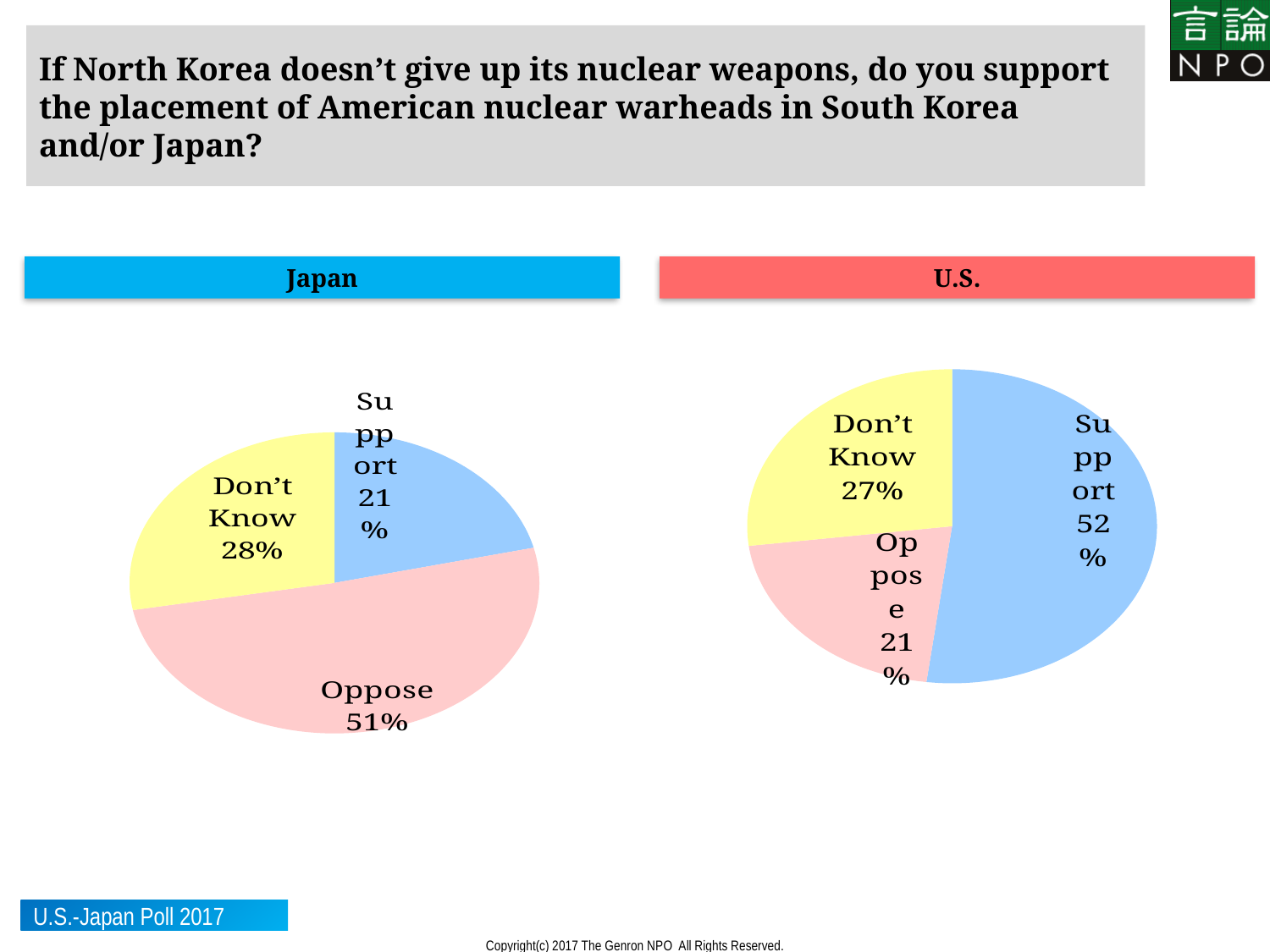
In the Japan pie chart, what percentage of respondents answered Oppose? 51% Which is larger: the Don't Know share in the Japan pie chart or the Don't Know share in the U.S. pie chart? Japan In the U.S. pie chart, what percentage answered Oppose? 21% How many slices does the U.S. pie chart have? 3 In the Japan pie chart, which response has the smallest share? Support In the Japan pie chart, what percentage answered Don't Know? 28% What type of chart is used to show the Japan results? Pie chart What is the difference between the Support share in the U.S. pie chart and the Support share in the Japan pie chart? 31 percentage points In the Japan pie chart, which response has the largest share? Oppose In the U.S. pie chart, what percentage of respondents answered Support? 52% In the Japan pie chart, what colour is the Oppose slice? Pink In the U.S. pie chart, which response has the smallest share? Oppose